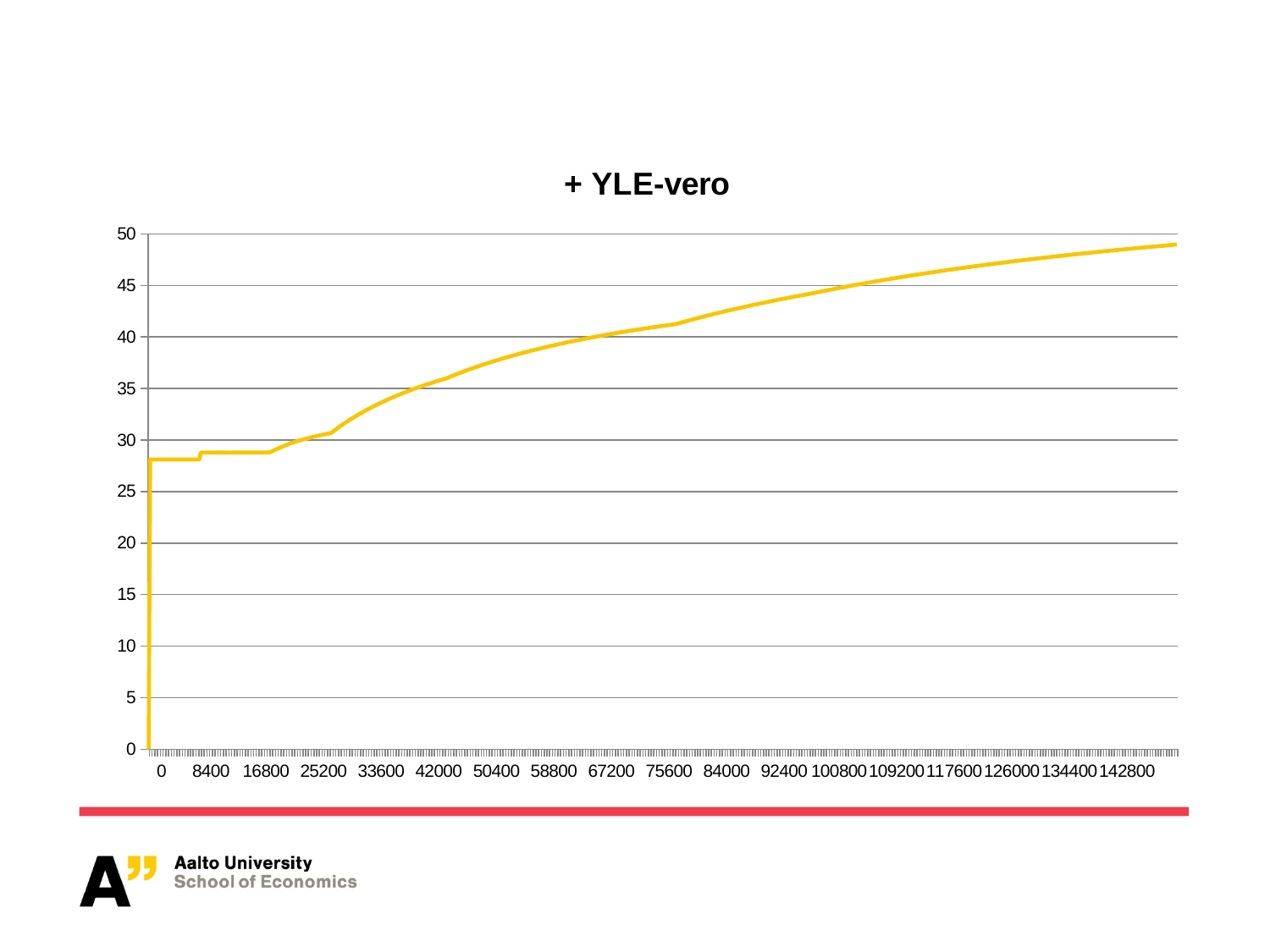
Is the value at x = 8400 greater or less than 30? less Is the value at x = 8400 greater or less than 25? greater What is the highest value shown on the y axis? 50 Is the value at x = 84000 greater or less than 40? greater What is the title of the chart? + YLE-vero Do the values on the chart generally rise or fall as the x axis increases? rise What kind of chart is shown on the slide? line chart Which is larger, the value at x = 142800 or the value at x = 8400? 142800